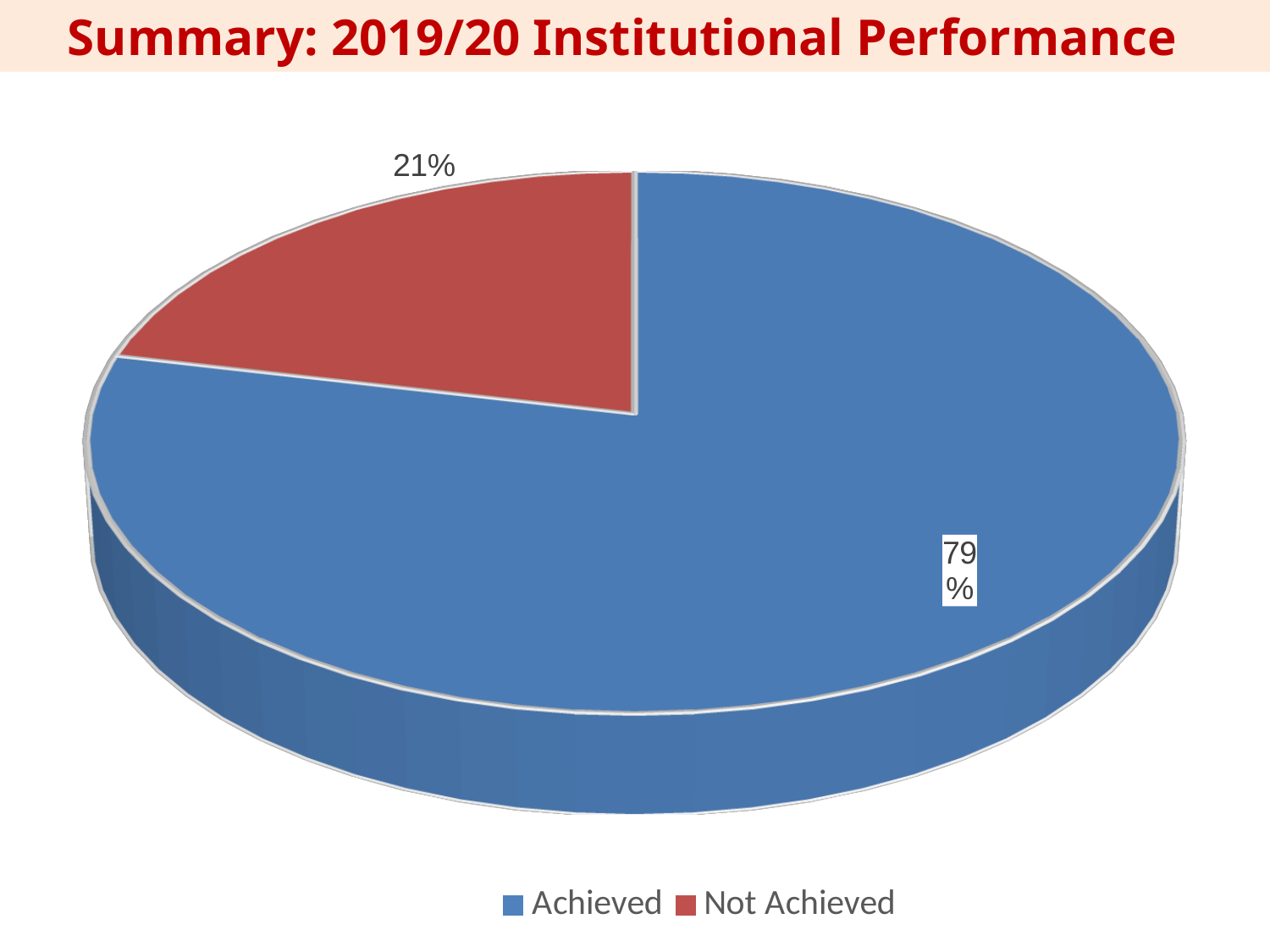
What is the difference in percentage points between the Achieved and Not Achieved slices? 58 Which is larger, the Achieved slice or the Not Achieved slice? Achieved How many entries does the legend list? 2 What percentage of the pie is labelled Not Achieved? 21% What share of the pie does the Not Achieved slice represent? 21% What is the title of the slide? Summary: 2019/20 Institutional Performance What kind of chart is shown on the slide? Pie chart What colour is the Achieved slice? Blue Which slice is the smallest? Not Achieved What percentage of the pie is labelled Achieved? 79% How many slices does the pie chart have? 2 Which slice is the largest? Achieved